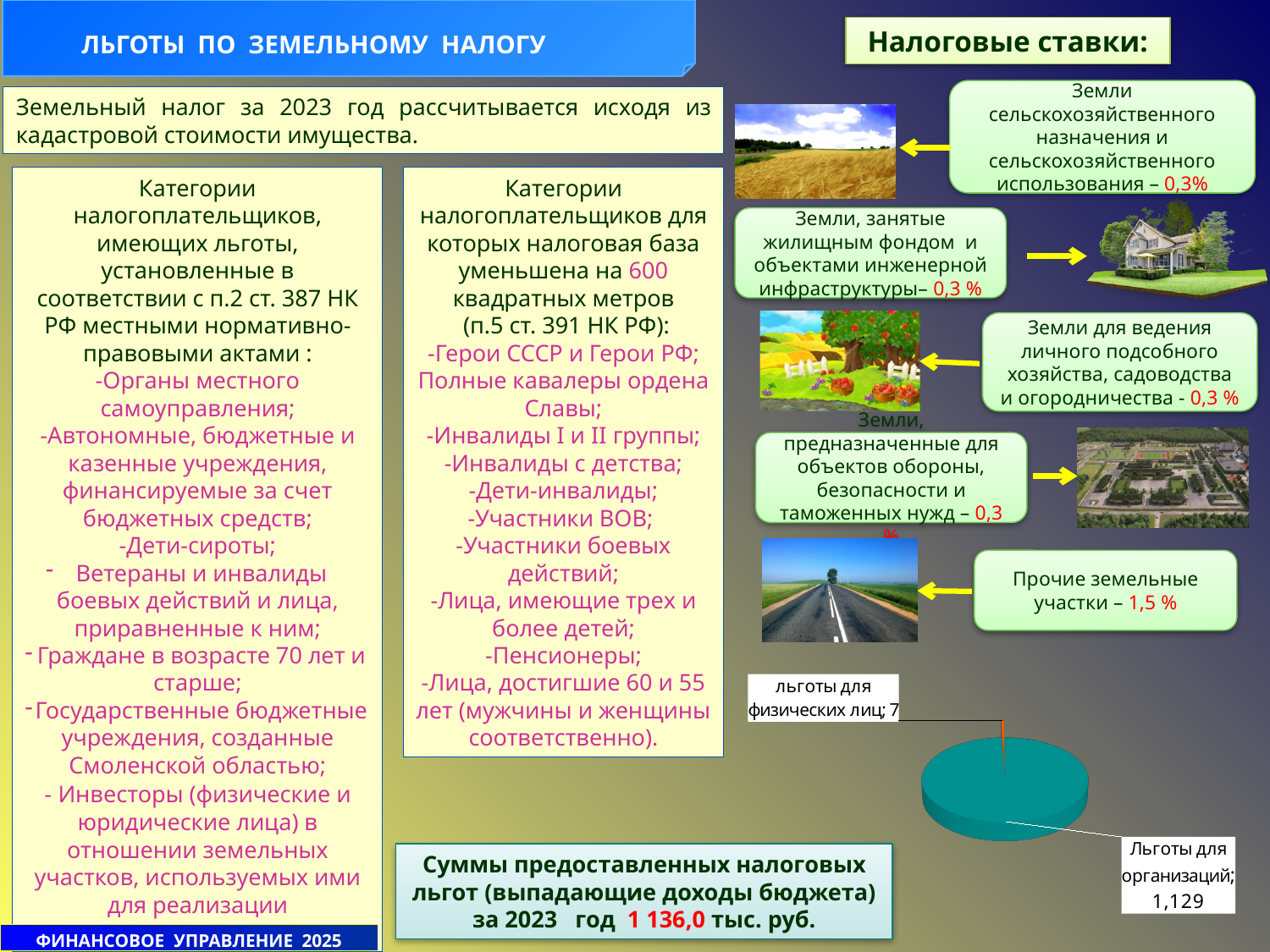
In the pie chart, which is larger: the value for "Льготы для организаций" or for "льготы для физических лиц"? Льготы для организаций Which category in the pie chart has the smallest value? льготы для физических лиц Which slice of the pie chart takes up almost the entire pie? Льготы для организаций In the pie chart, what is the value for "льготы для физических лиц"? 7 In the pie chart, what is the value for "Льготы для организаций"? 1,129 What kind of chart is shown at the bottom right of the slide? pie chart In the pie chart, what is the difference between the value for "Льготы для организаций" and the value for "льготы для физических лиц"? 1,122 How many categories (slices) does the pie chart show? 2 What is the total of the two values shown in the pie chart? 1,136 Which category in the pie chart has the largest value? Льготы для организаций